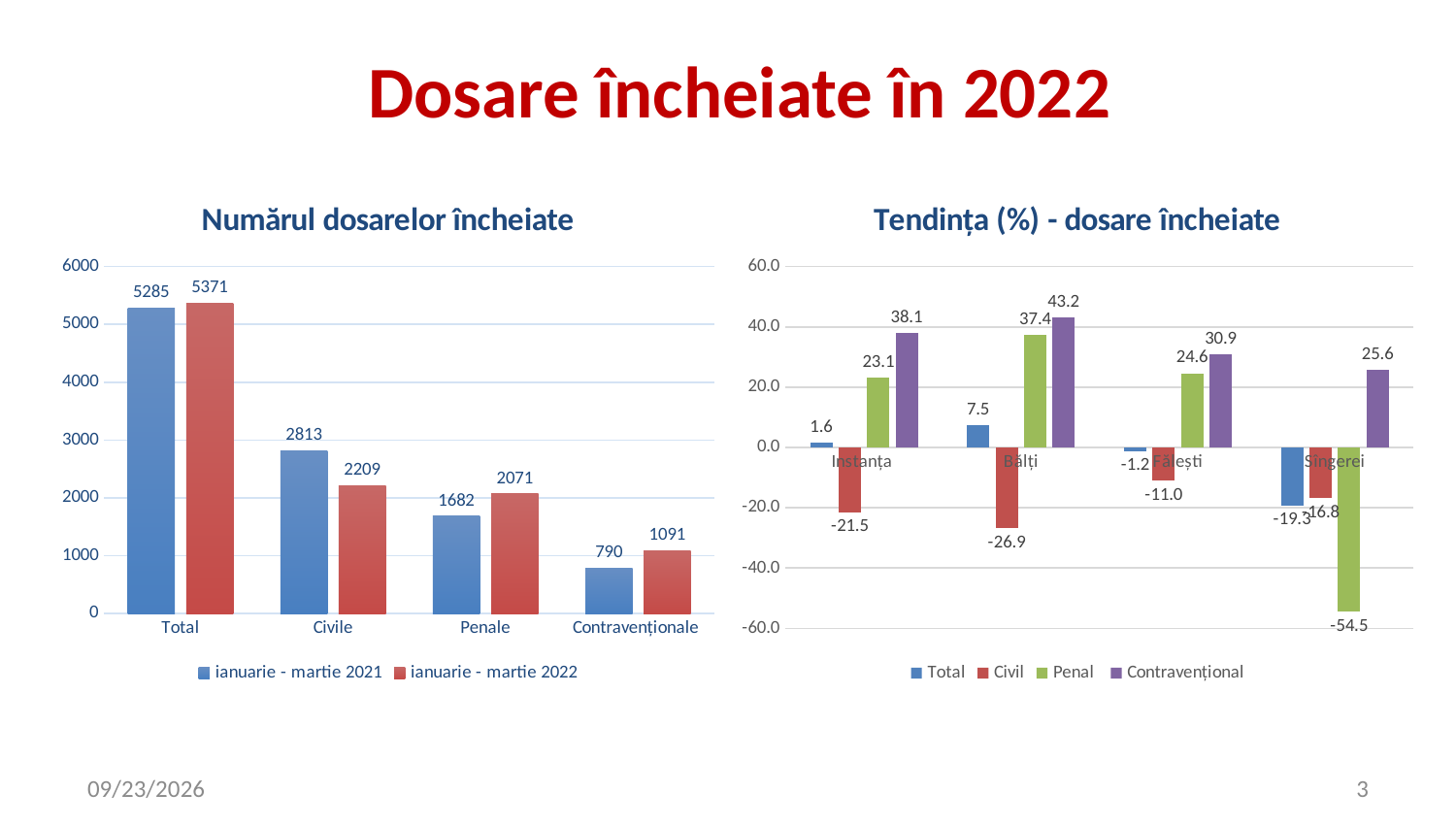
In the chart 'Numărul dosarelor încheiate', which is larger for Penale: ianuarie - martie 2021 or ianuarie - martie 2022? ianuarie - martie 2022 In the chart 'Tendința (%) - dosare încheiate', what is the Civil value for Bălți? -26.9 In the chart 'Tendința (%) - dosare încheiate', how many categories are shown on the x axis? 4 In the chart 'Tendința (%) - dosare încheiate', what is the difference between the Contravențional and Penal values for Instanța? 15.0 What kind of chart is 'Numărul dosarelor încheiate'? bar chart In the chart 'Numărul dosarelor încheiate', what is the value for Contravenționale in ianuarie - martie 2022? 1091 In the chart 'Numărul dosarelor încheiate', what is the difference between the Total values for ianuarie - martie 2022 and ianuarie - martie 2021? 86 In the chart 'Tendința (%) - dosare încheiate', what is the Penal value for Sîngerei? -54.5 In the chart 'Tendința (%) - dosare încheiate', which category has the highest Contravențional value? Bălți In the chart 'Numărul dosarelor încheiate', how many series does the legend list? 2 In the chart 'Tendința (%) - dosare încheiate', which category has the lowest Total value? Sîngerei In the chart 'Numărul dosarelor încheiate', what is the value for Civile in ianuarie - martie 2021? 2813